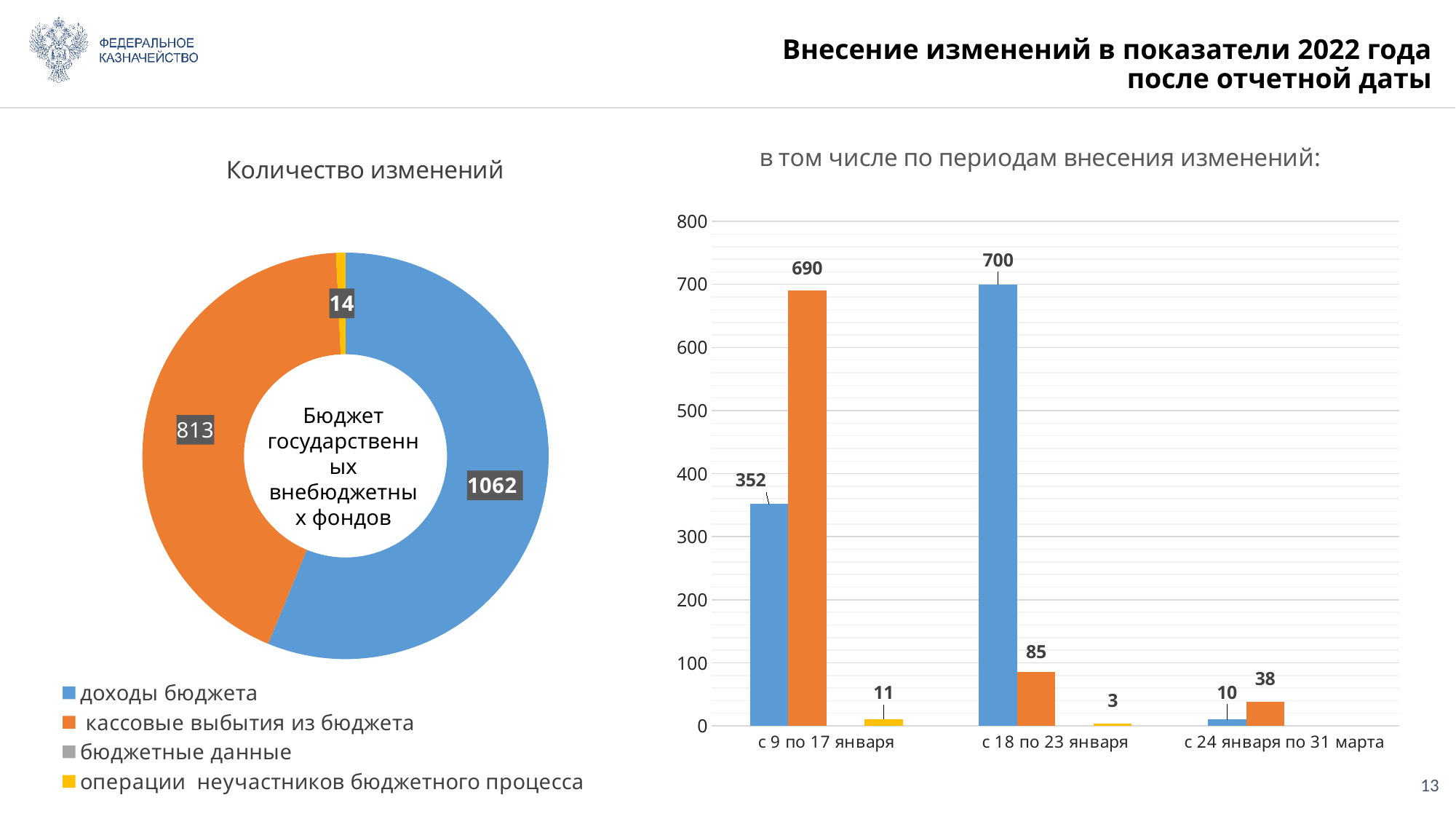
In the bar chart on the right, what is the value of the yellow bar for "с 18 по 23 января"? 3 What kind of chart is the chart titled "Количество изменений"? doughnut chart In the chart titled "Количество изменений", which legend category has the largest value? доходы бюджета In the bar chart on the right, what is the difference between the blue bar values for "с 18 по 23 января" and "с 9 по 17 января"? 348 In the chart titled "Количество изменений", what is the value for "кассовые выбытия из бюджета"? 813 In the bar chart on the right, which is larger for "с 24 января по 31 марта": the blue bar or the orange bar? the orange bar In the bar chart on the right, what is the value of the blue bar for "с 18 по 23 января"? 700 In the bar chart on the right, what is the value of the orange bar for "с 9 по 17 января"? 690 In the chart titled "Количество изменений", what is the value for "доходы бюджета"? 1062 In the chart titled "Количество изменений", how many entries does the legend list? 4 In the bar chart on the right, how many categories are shown on the x axis? 3 In the chart titled "Количество изменений", what is the difference between the values for "доходы бюджета" and "кассовые выбытия из бюджета"? 249